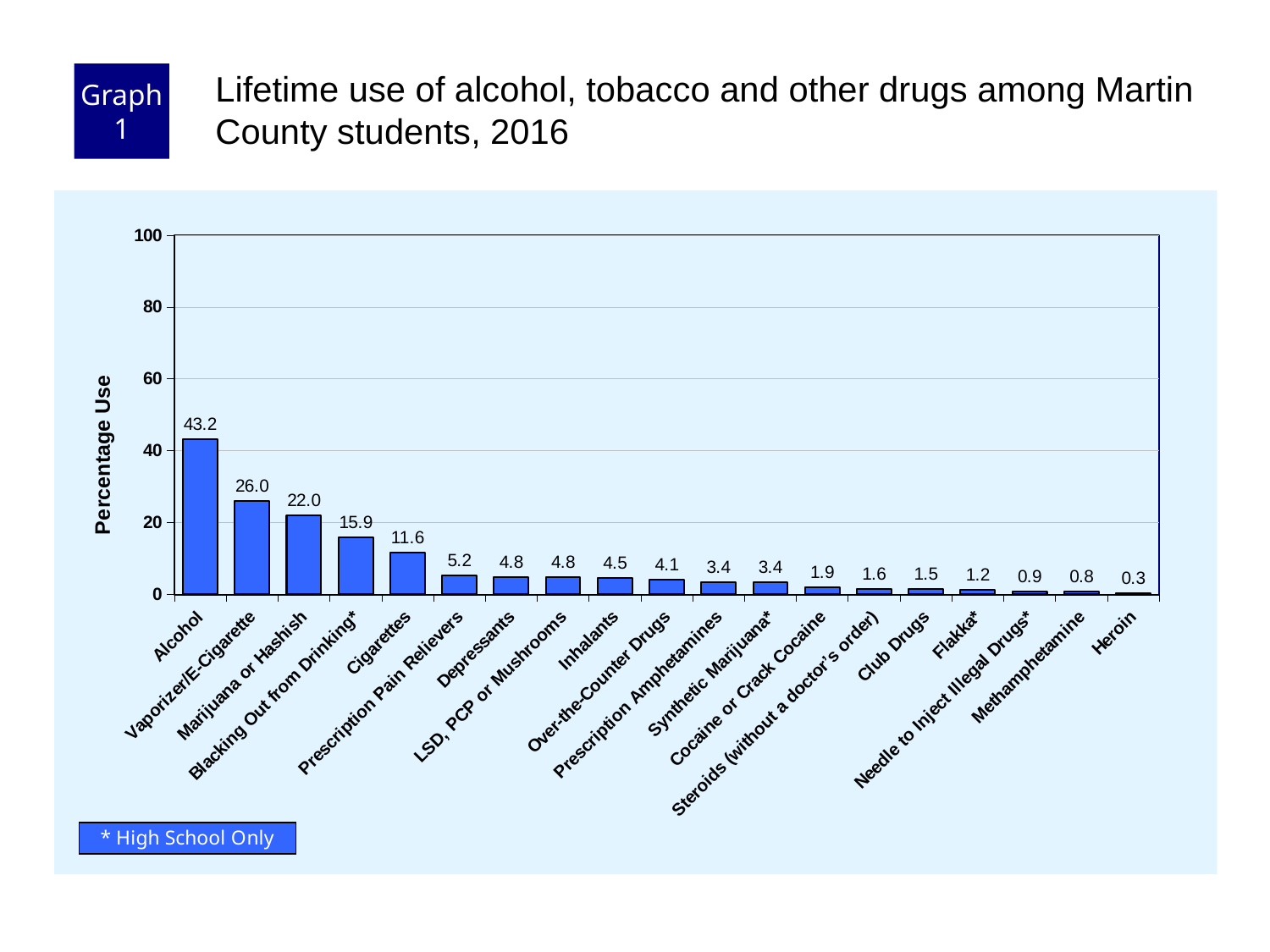
What is the value shown for Synthetic Marijuana*? 3.4 Is the value for Vaporizer/E-Cigarette greater or less than 20? greater What is the difference between the values for Marijuana or Hashish and Blacking Out from Drinking*? 6.1 How many categories are shown on the x axis? 19 What is the value shown for Cigarettes? 11.6 What kind of chart is shown on the slide? Bar chart Which is larger, the value for Inhalants or the value for Over-the-Counter Drugs? Inhalants Which category has the highest value? Alcohol What is the lifetime use percentage for Alcohol? 43.2 What is the difference between the values for Alcohol and Vaporizer/E-Cigarette? 17.2 What is the label of the y axis? Percentage Use Which category has the lowest value? Heroin